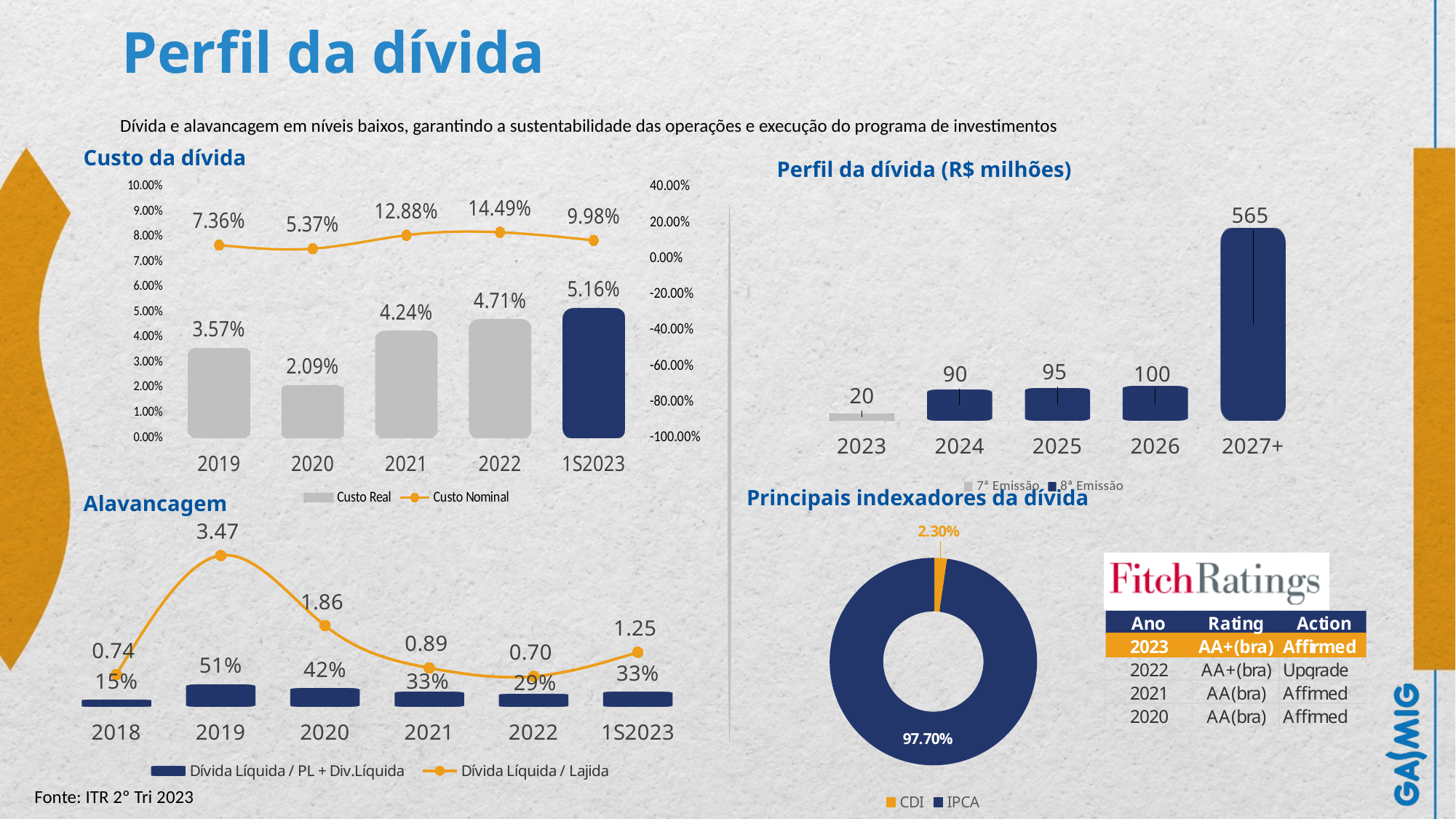
In the 'Custo da dívida' chart, which period has the lowest Custo Real? 2020 In the 'Principais indexadores da dívida' chart, what share does CDI represent? 2.30% In the 'Custo da dívida' chart, what is the Custo Nominal value for 2022? 14.49% In the 'Perfil da dívida (R$ milhões)' chart, what is the value for 2027+? 565 In the 'Alavancagem' chart, what is the Dívida Líquida / Lajida value for 2019? 3.47 In the 'Custo da dívida' chart, which period has the highest Custo Nominal? 2022 In the 'Alavancagem' chart, what is the Dívida Líquida / PL + Div.Líquida value for 2020? 42% In the 'Custo da dívida' chart, how many series does the legend list? 2 In the 'Perfil da dívida (R$ milhões)' chart, do the values rise or fall from 2023 to 2027+? rise In the 'Custo da dívida' chart, what is the Custo Real value for 2021? 4.24% In the 'Perfil da dívida (R$ milhões)' chart, what is the difference between the values for 2026 and 2024? 10 In the 'Perfil da dívida (R$ milhões)' chart, how many categories are shown on the x axis? 5